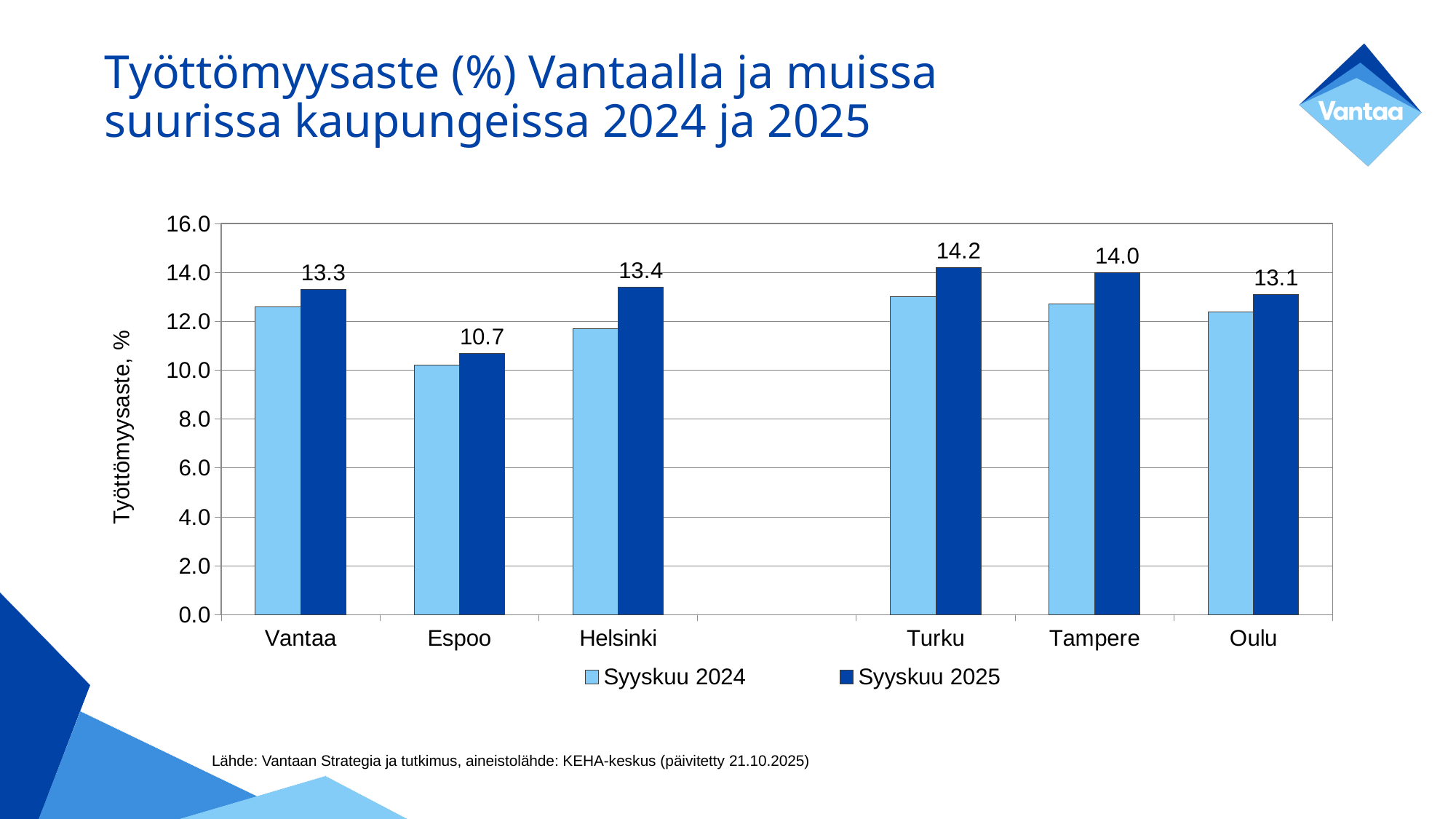
What is the unemployment rate for Turku in Syyskuu 2025? 14.2 Which is larger in Syyskuu 2025, the unemployment rate of Tampere or Oulu? Tampere Is the Syyskuu 2024 value for Turku greater or less than 12.0? greater How many series does the legend list? 2 What is the unemployment rate for Espoo in Syyskuu 2025? 10.7 Which city has the highest unemployment rate in Syyskuu 2025? Turku How many cities are shown on the x axis? 6 Which city has the lowest unemployment rate in Syyskuu 2025? Espoo What kind of chart is shown on the slide? Bar chart What is the unemployment rate for Vantaa in Syyskuu 2025? 13.3 What is the difference between the Syyskuu 2025 unemployment rates of Turku and Espoo? 3.5 Is the Syyskuu 2024 value for Helsinki greater or less than 12.0? less